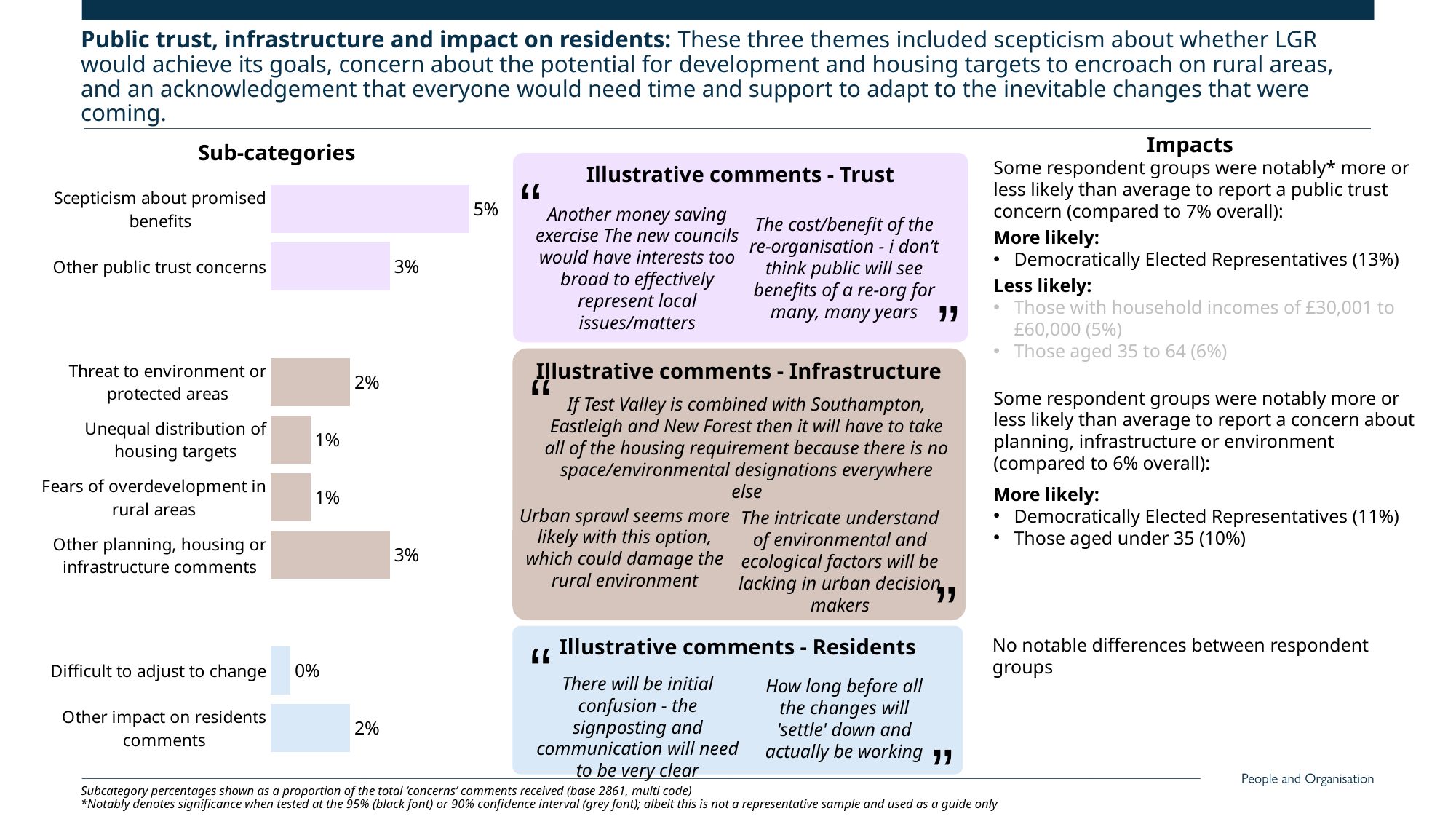
How many sub-categories are plotted in the Sub-categories chart? 8 What is the value for 'Other impact on residents comments' in the Sub-categories chart? 2% What is the value for 'Scepticism about promised benefits' in the Sub-categories chart? 5% What kind of chart is the Sub-categories chart? Bar chart Which sub-category has the highest value in the Sub-categories chart? Scepticism about promised benefits What is the value for 'Other public trust concerns' in the Sub-categories chart? 3% What is the value for 'Threat to environment or protected areas' in the Sub-categories chart? 2% Which sub-category has the lowest value in the Sub-categories chart? Difficult to adjust to change In the Sub-categories chart, which is larger: 'Threat to environment or protected areas' or 'Unequal distribution of housing targets'? Threat to environment or protected areas What is the value for 'Difficult to adjust to change' in the Sub-categories chart? 0% What is the title of the chart on the left of the slide? Sub-categories What is the difference between 'Scepticism about promised benefits' and 'Other public trust concerns' in the Sub-categories chart? 2 percentage points